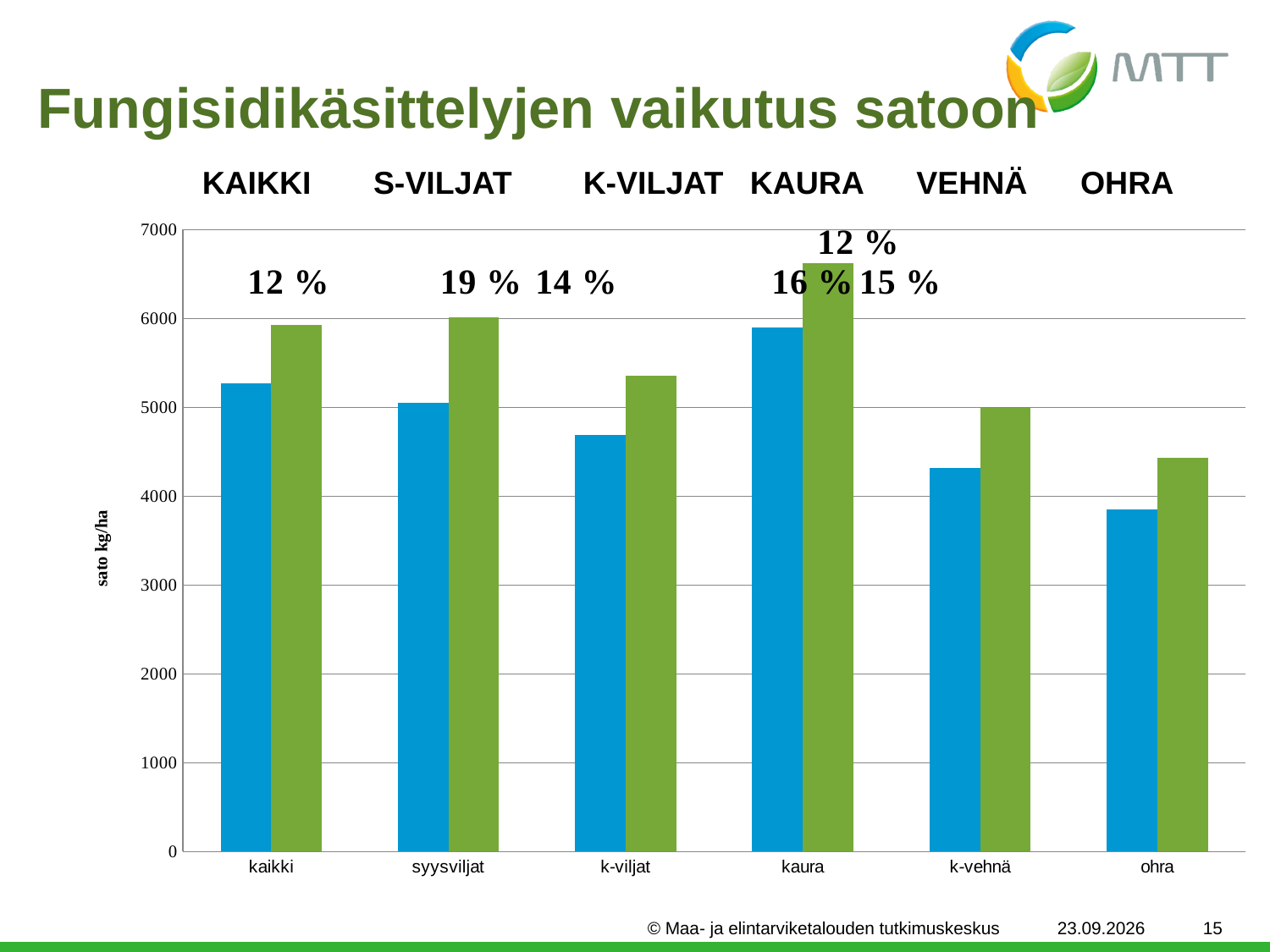
Is the value of the blue bar for ohra greater or less than 4000? less How many categories are shown along the x axis of the chart? 6 What kind of chart is shown on the slide? bar chart Which is larger for syysviljat, the blue bar or the green bar? the green bar Which category has the shortest blue bar? ohra Is the value of the blue bar for k-viljat greater or less than 5000? less Is the value of the blue bar for kaikki greater or less than 5000? greater Which category has the tallest green bar? kaura What is the title of the y axis of the chart? sato kg/ha Which category has the tallest blue bar? kaura What percentage label is printed above the bars for syysviljat? 19 %